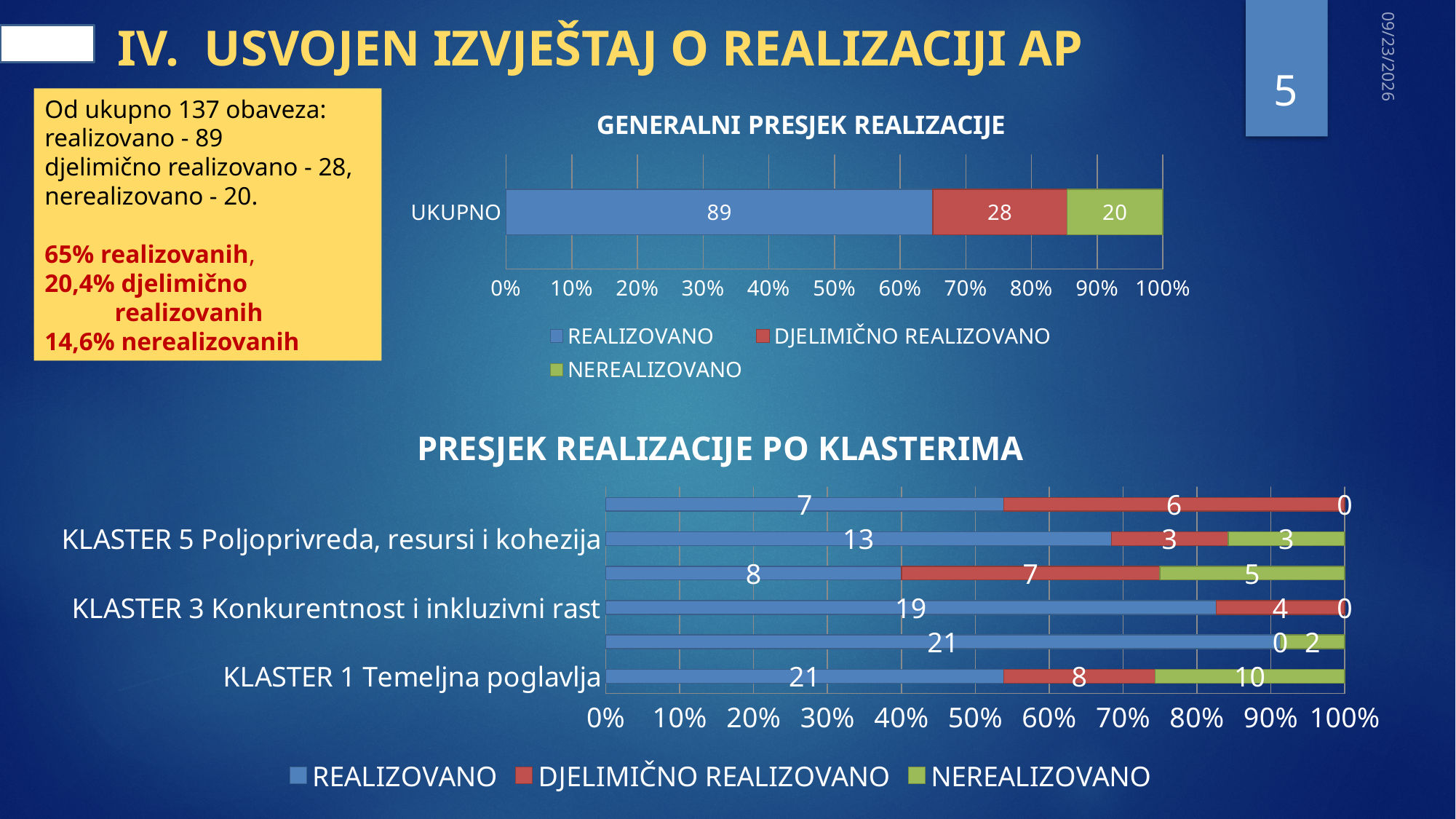
In the chart titled PRESJEK REALIZACIJE PO KLASTERIMA, what is the DJELIMIČNO REALIZOVANO value for KLASTER 5 Poljoprivreda, resursi i kohezija? 3 In the chart titled PRESJEK REALIZACIJE PO KLASTERIMA, what is the REALIZOVANO value for KLASTER 1 Temeljna poglavlja? 21 In the chart titled GENERALNI PRESJEK REALIZACIJE, what is the REALIZOVANO value for UKUPNO? 89 In the chart titled PRESJEK REALIZACIJE PO KLASTERIMA, which has the larger NEREALIZOVANO value: KLASTER 1 Temeljna poglavlja or KLASTER 5 Poljoprivreda, resursi i kohezija? KLASTER 1 Temeljna poglavlja In the chart titled PRESJEK REALIZACIJE PO KLASTERIMA, what is the total of the KLASTER 1 Temeljna poglavlja bar across all three series? 39 What kind of chart is the chart titled GENERALNI PRESJEK REALIZACIJE? Stacked bar chart In the chart titled PRESJEK REALIZACIJE PO KLASTERIMA, what is the difference between the REALIZOVANO values for KLASTER 3 Konkurentnost i inkluzivni rast and KLASTER 5 Poljoprivreda, resursi i kohezija? 6 In the chart titled GENERALNI PRESJEK REALIZACIJE, what is the total of the UKUPNO bar across all three series? 137 In the chart titled GENERALNI PRESJEK REALIZACIJE, does the REALIZOVANO segment of the UKUPNO bar end at a point greater or less than 60%? greater In the chart titled GENERALNI PRESJEK REALIZACIJE, what is the NEREALIZOVANO value for UKUPNO? 20 In the chart titled GENERALNI PRESJEK REALIZACIJE, how many series does the legend list? 3 In the chart titled PRESJEK REALIZACIJE PO KLASTERIMA, what is the NEREALIZOVANO value for KLASTER 3 Konkurentnost i inkluzivni rast? 0